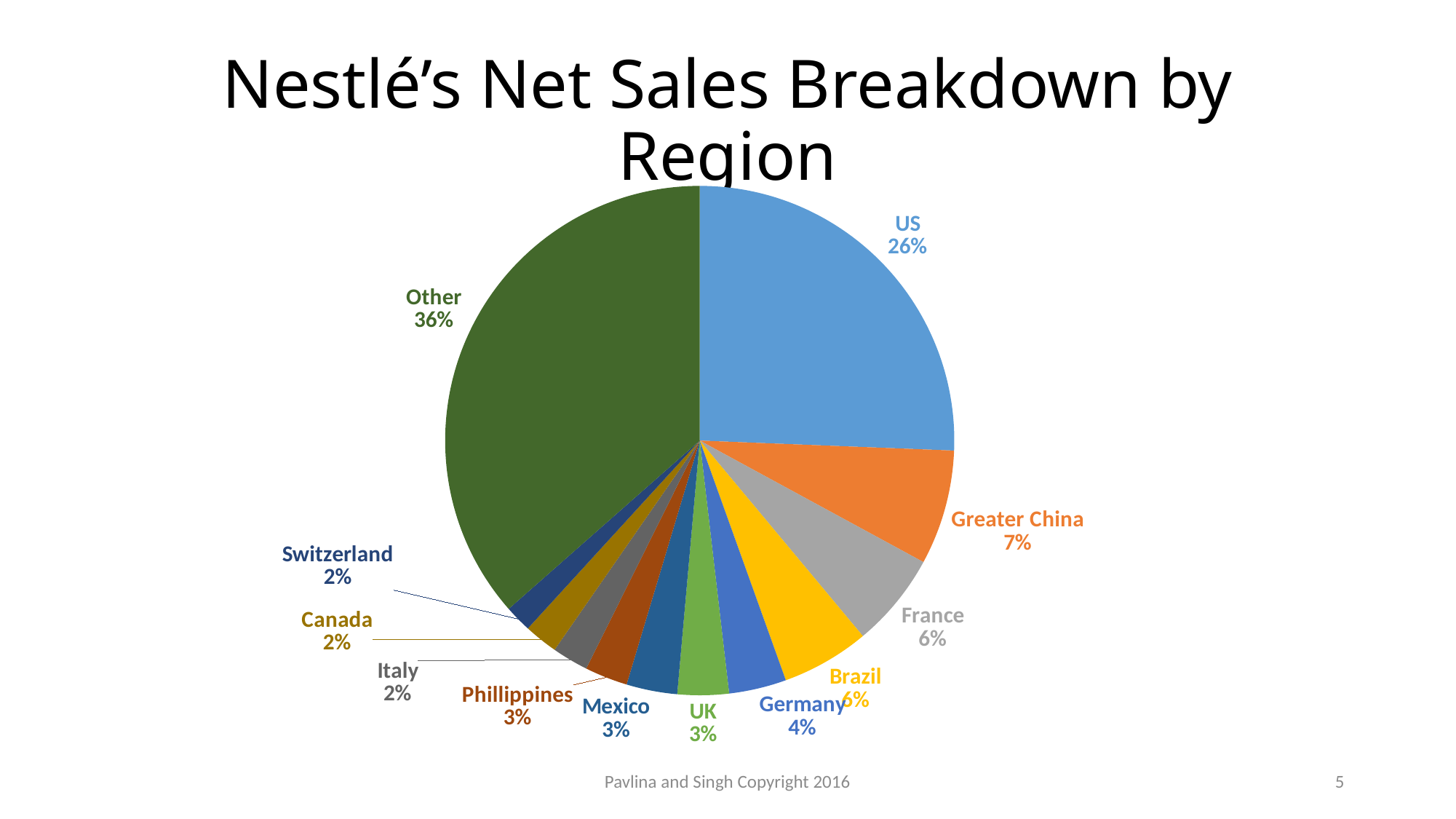
What is the difference in percentage points between the US share and the Greater China share? 19 What share of net sales is labelled as Other? 36% Which slice of the pie is the largest? Other What kind of chart is shown on the slide? Pie chart Which named country has the largest share of net sales? US How many slices does the pie chart have? 12 What percentage of net sales comes from Greater China? 7% What share of Nestlé's net sales comes from the US? 26% Which is larger, the share for France or the share for Germany? France What is the combined share of Brazil and France? 12% What is the title of the chart? Nestlé's Net Sales Breakdown by Region What percentage of net sales comes from Germany? 4%